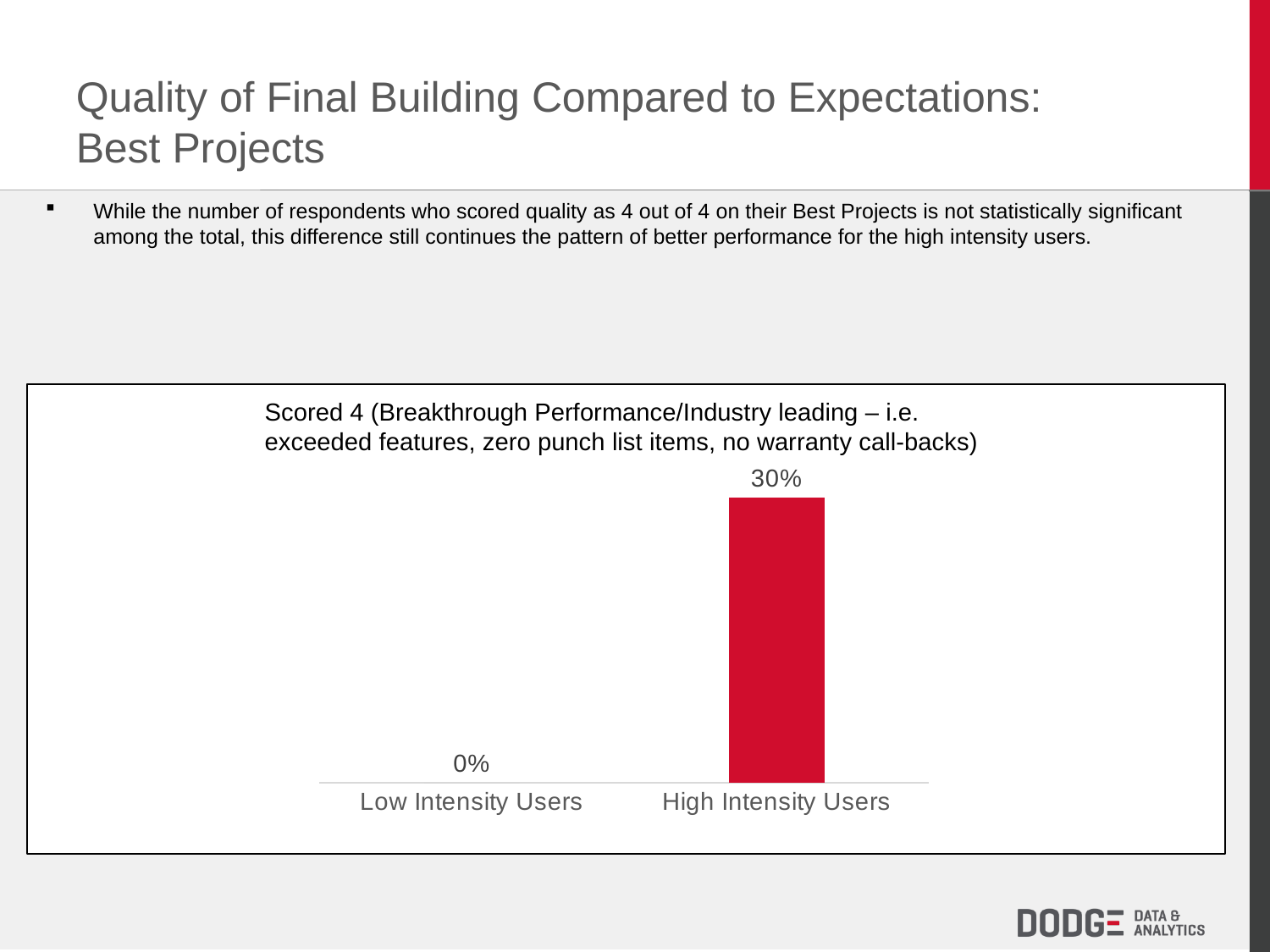
What is the value for High Intensity Users? 30% What colour is the bar for High Intensity Users? Red What is the difference between the values for High Intensity Users and Low Intensity Users? 30% What is the title of the chart? Scored 4 (Breakthrough Performance/Industry leading – i.e. exceeded features, zero punch list items, no warranty call-backs) Do the values rise or fall from Low Intensity Users to High Intensity Users? Rise Which category has the highest value? High Intensity Users What is the value for Low Intensity Users? 0% How many categories are shown on the x axis of the chart? 2 Which is larger, the value for Low Intensity Users or the value for High Intensity Users? High Intensity Users Which category has the lowest value? Low Intensity Users What kind of chart is shown on the slide? Bar chart